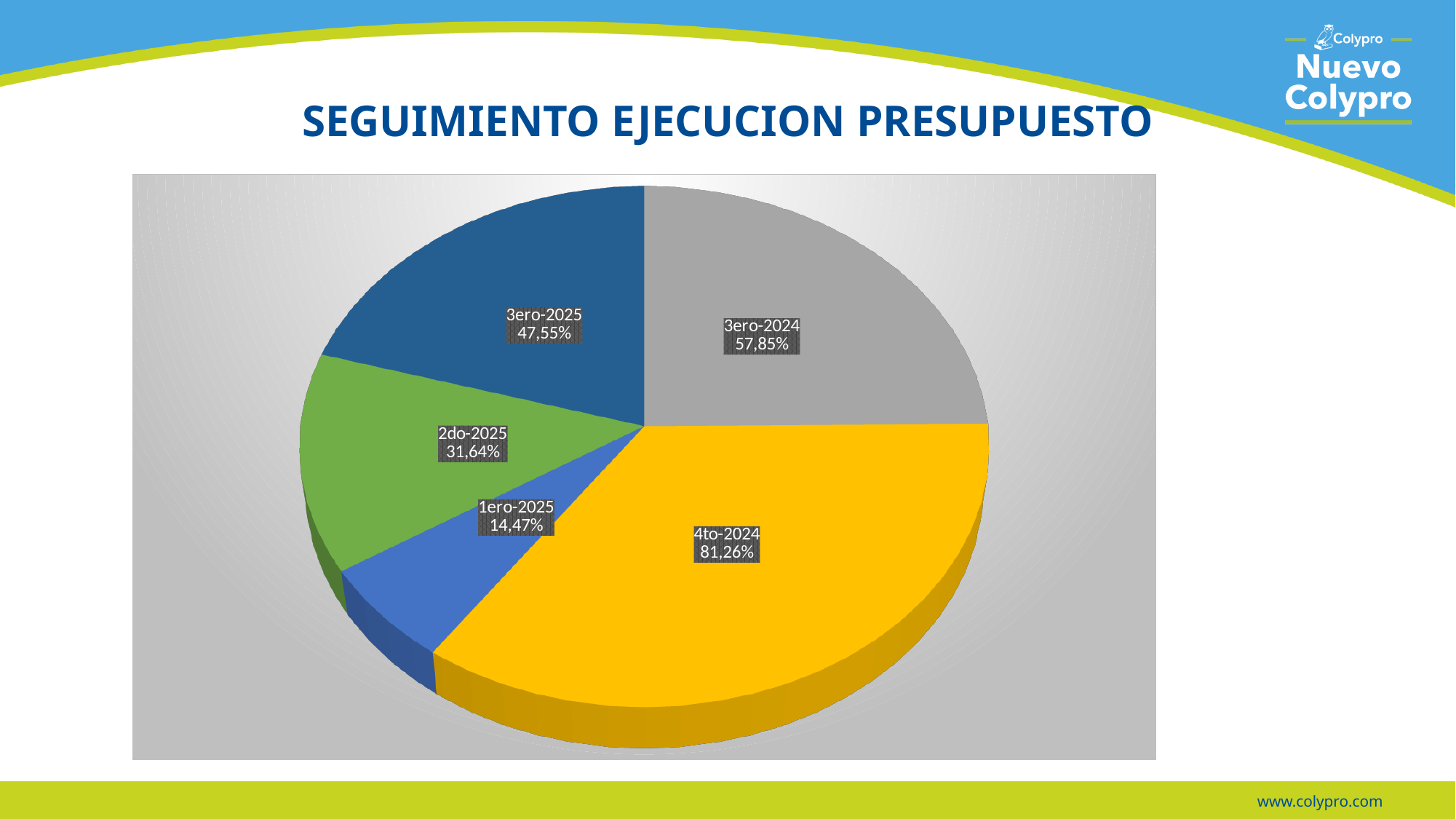
What kind of chart is shown on the slide? Pie chart What is the value shown for 2do-2025? 31,64% What is the title of the chart on the slide? SEGUIMIENTO EJECUCION PRESUPUESTO How many slices does the pie chart have? 5 What is the value shown for 4to-2024? 81,26% What is the value shown for 3ero-2024? 57,85% What is the value shown for 3ero-2025? 47,55% Which slice has the lowest value? 1ero-2025 Which slice has the highest value? 4to-2024 What is the value shown for 1ero-2025? 14,47% What is the difference between the values for 4to-2024 and 3ero-2024? 23,41% Which is larger, the value for 3ero-2025 or the value for 2do-2025? 3ero-2025